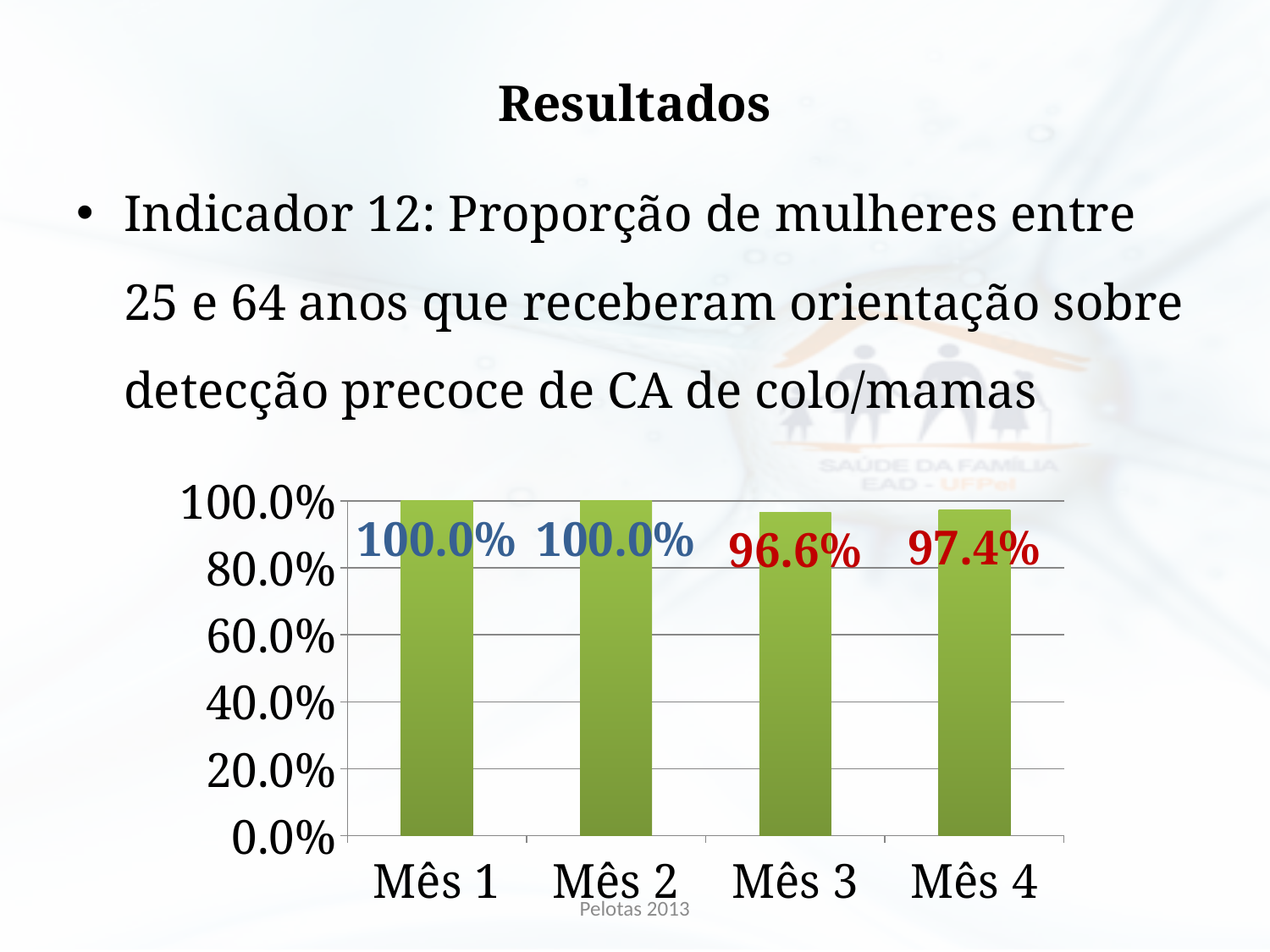
Is the value for Mês 3 greater or less than 80.0%? greater Do the values rise or fall from Mês 2 to Mês 3? fall How many months are shown on the x axis? 4 Which month has the lowest value? Mês 3 What kind of chart is shown on the slide? bar chart What is the difference between the values for Mês 2 and Mês 3? 3.4% What is the value for Mês 1? 100.0% What is the difference between the values for Mês 4 and Mês 3? 0.8% What is the value for Mês 3? 96.6% Which is larger, the value for Mês 3 or the value for Mês 4? Mês 4 What is the value for Mês 4? 97.4% What colour are the bars in the chart? green